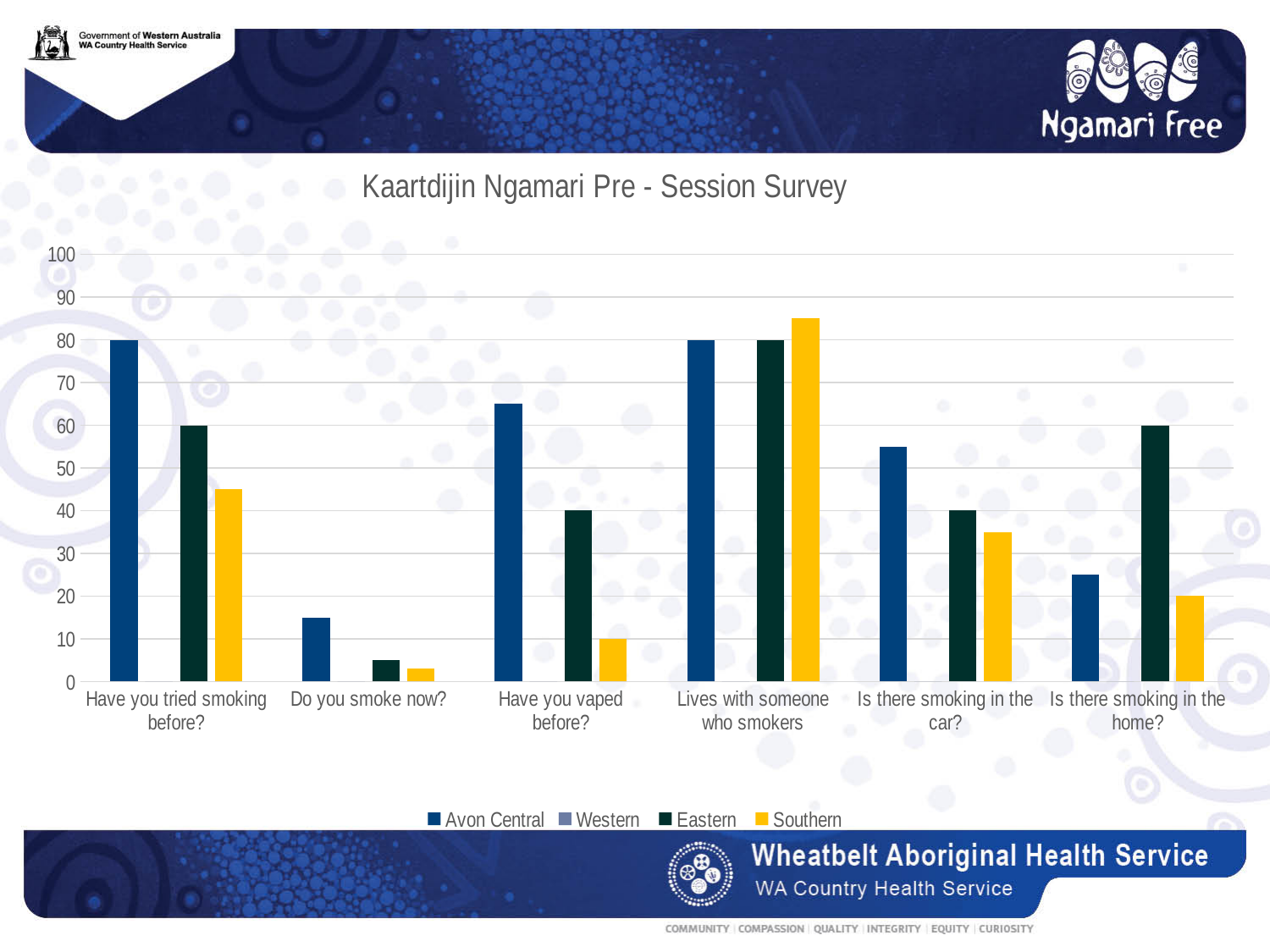
For 'Is there smoking in the home?', which is larger: Avon Central or Eastern? Eastern What is the value for Eastern for 'Have you vaped before?' 40 How many survey questions (categories) are shown along the x axis? 6 What is the value for Avon Central for 'Have you tried smoking before?' 80 How many series does the legend list? 4 What is the value for Eastern for 'Have you tried smoking before?' 60 Which region has the highest value for 'Lives with someone who smokers'? Southern Is the value for Avon Central for 'Is there smoking in the car?' greater or less than 50? greater What is the value for Southern for 'Is there smoking in the home?' 20 What kind of chart is shown on the slide? Bar chart What is the title of the chart? Kaartdijin Ngamari Pre - Session Survey